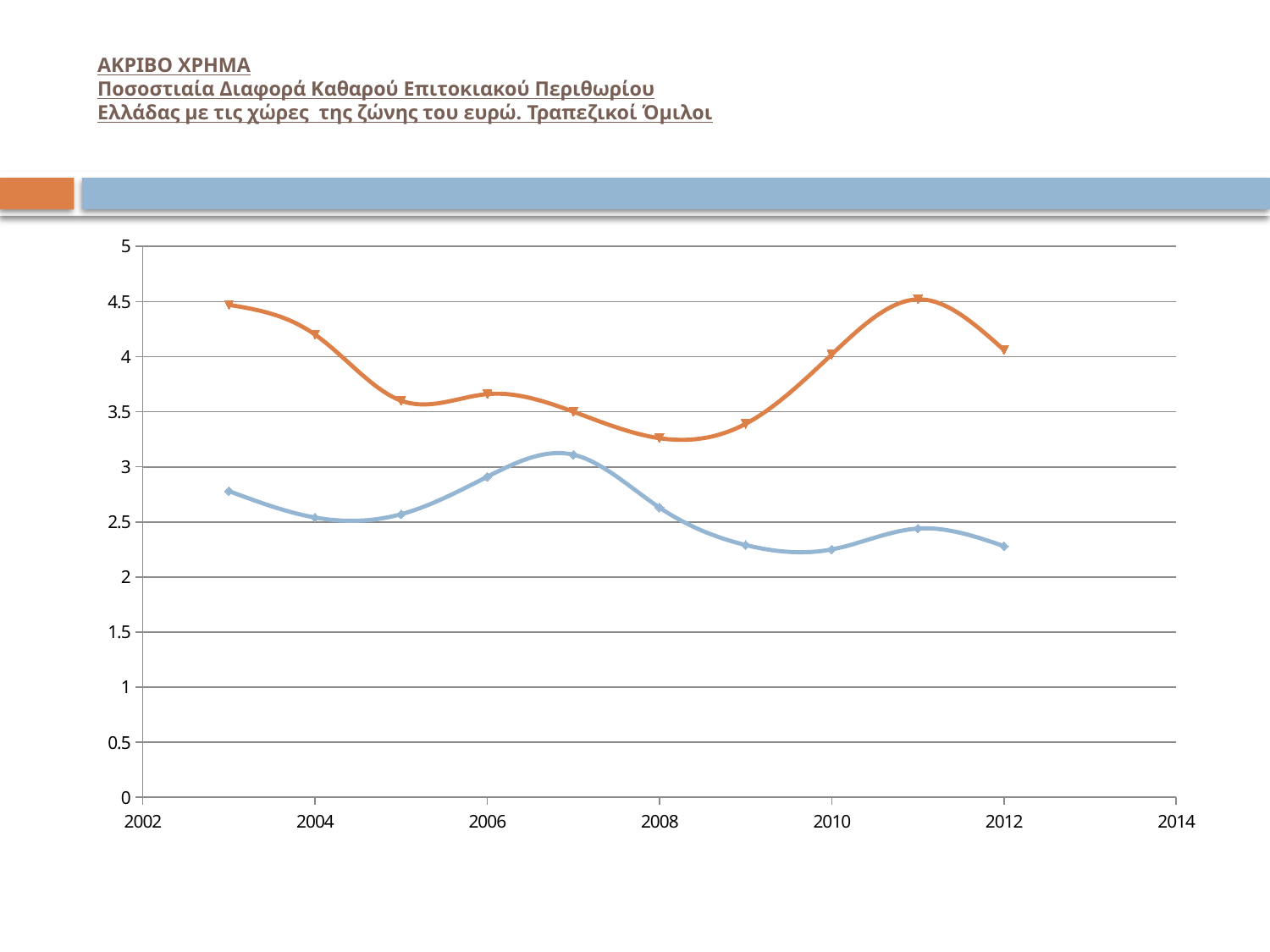
How many lines (series) are plotted on the chart? 2 What kind of chart is shown on the slide? line chart In which year does the blue line reach its highest value? 2007 Is the value of the orange line in 2003 greater or less than 4? greater How many data points does the orange line have? 10 What is the first line of the slide's heading above the chart? ΑΚΡΙΒΟ ΧΡΗΜΑ Does the blue line rise or fall between 2007 and 2010? fall Is the value of the blue line in 2010 greater or less than 2.5? less Is the value of the blue line in 2007 greater or less than 3? greater In 2008, which line has the higher value, the orange line or the blue line? orange line In which year does the orange line reach its lowest value? 2008